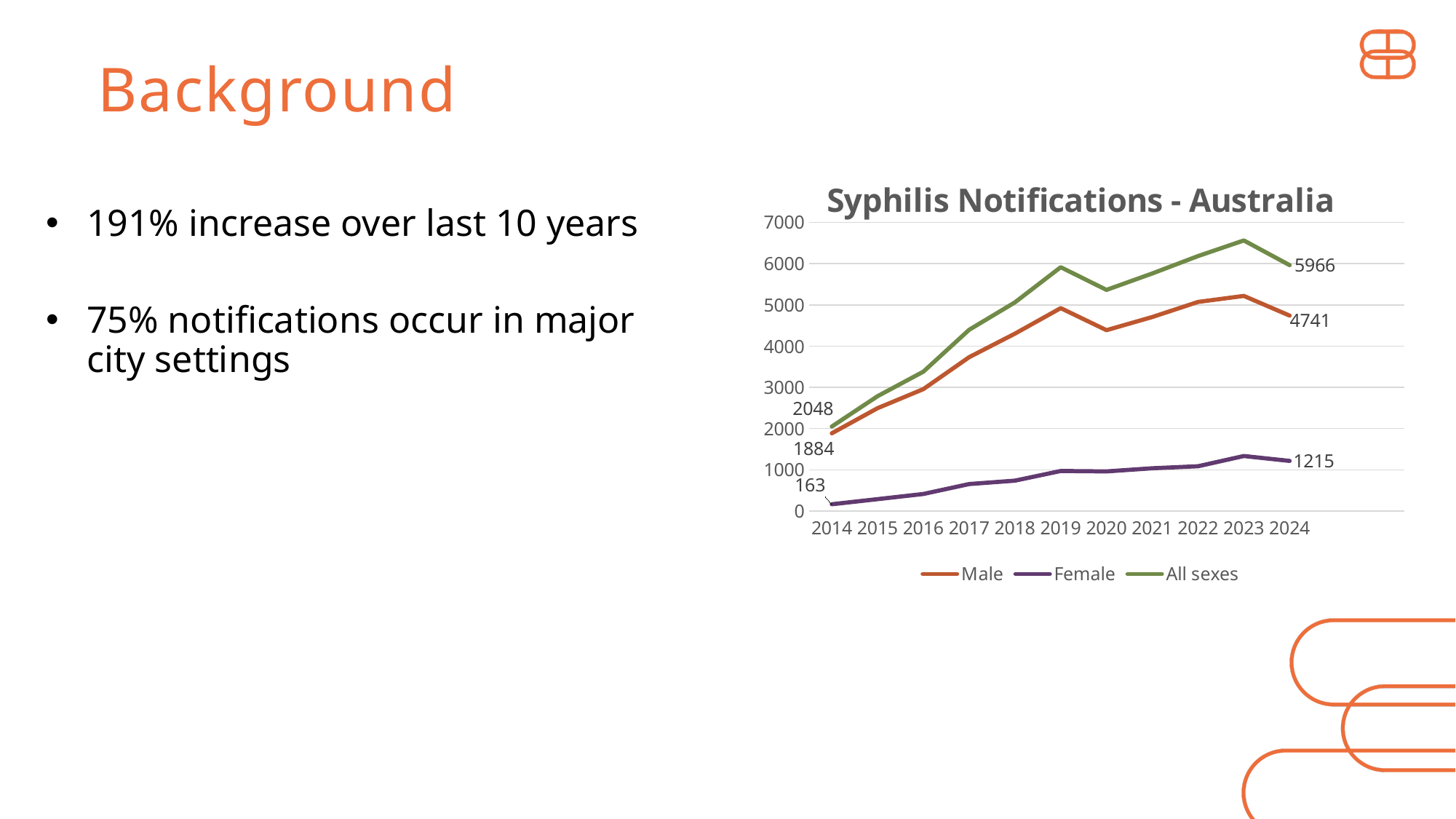
What is the difference between the Male value in 2024 and the Male value in 2014? 2857 Does the Female line generally rise or fall from 2014 to 2024? rise What is the value for Female in 2024? 1215 What is the value for Male in 2014? 1884 What kind of chart is shown on the slide? line chart Is the value for All sexes in 2023 greater or less than 6000? greater By how much did the All sexes value increase from 2014 to 2024? 3918 In 2024, which is larger: the Male value or the Female value? Male What is the value for All sexes in 2024? 5966 What is the value for Female in 2014? 163 How many years are shown on the x axis? 11 How many series does the legend of the Syphilis Notifications - Australia chart list? 3